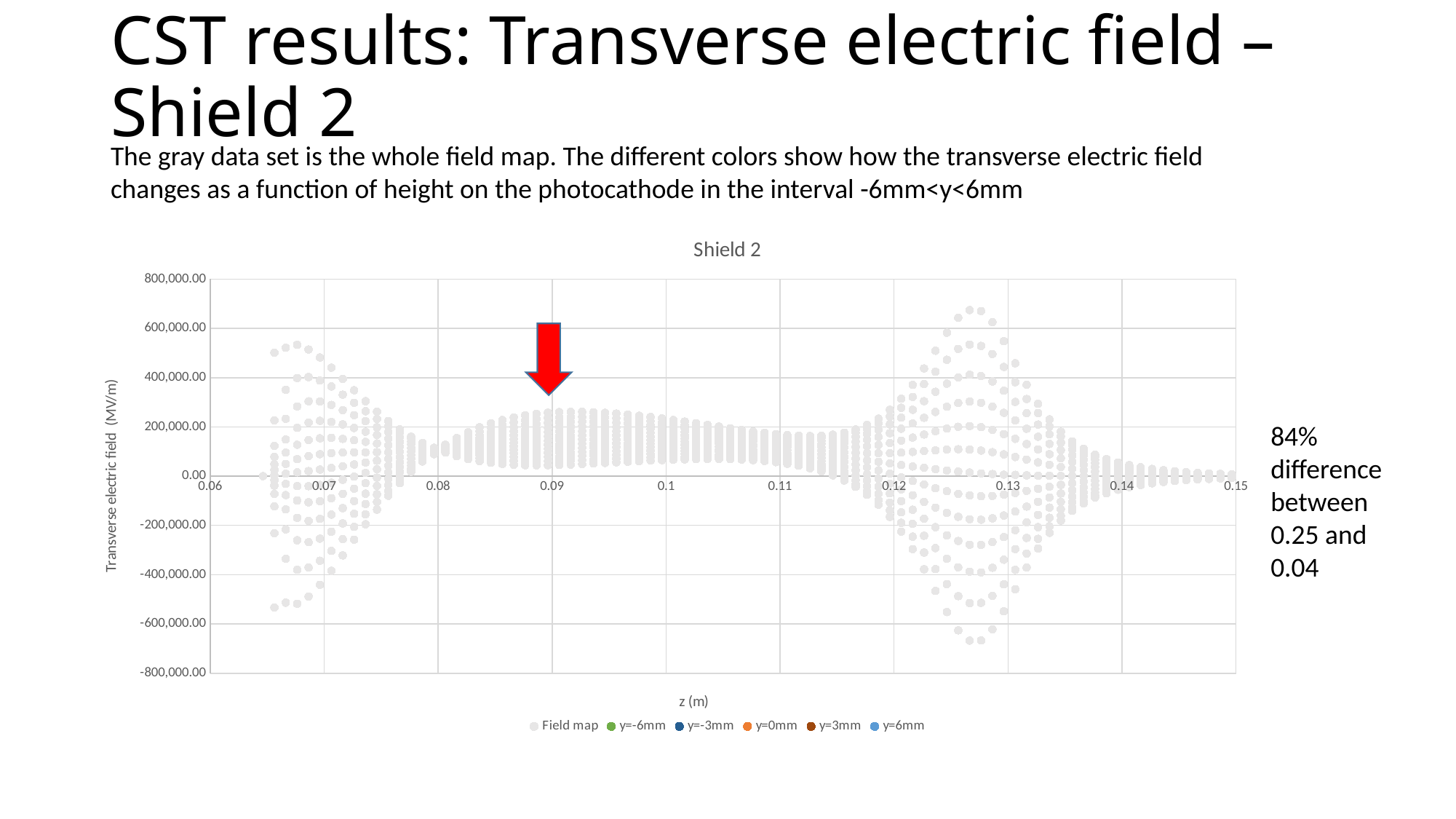
How many series does the legend of the Shield 2 chart list? 6 Which region has the larger peak field map value: around z = 0.07 or around z = 0.13? around z = 0.13 Is the highest field map value near z = 0.13 greater or less than 600,000.00? greater Is the highest field map value near z = 0.07 greater or less than 600,000.00? less Is the lowest field map value near z = 0.13 greater or less than -600,000.00? less What is the title of the chart? Shield 2 What kind of chart is shown on the slide? scatter chart Which series in the legend is plotted in gray? Field map